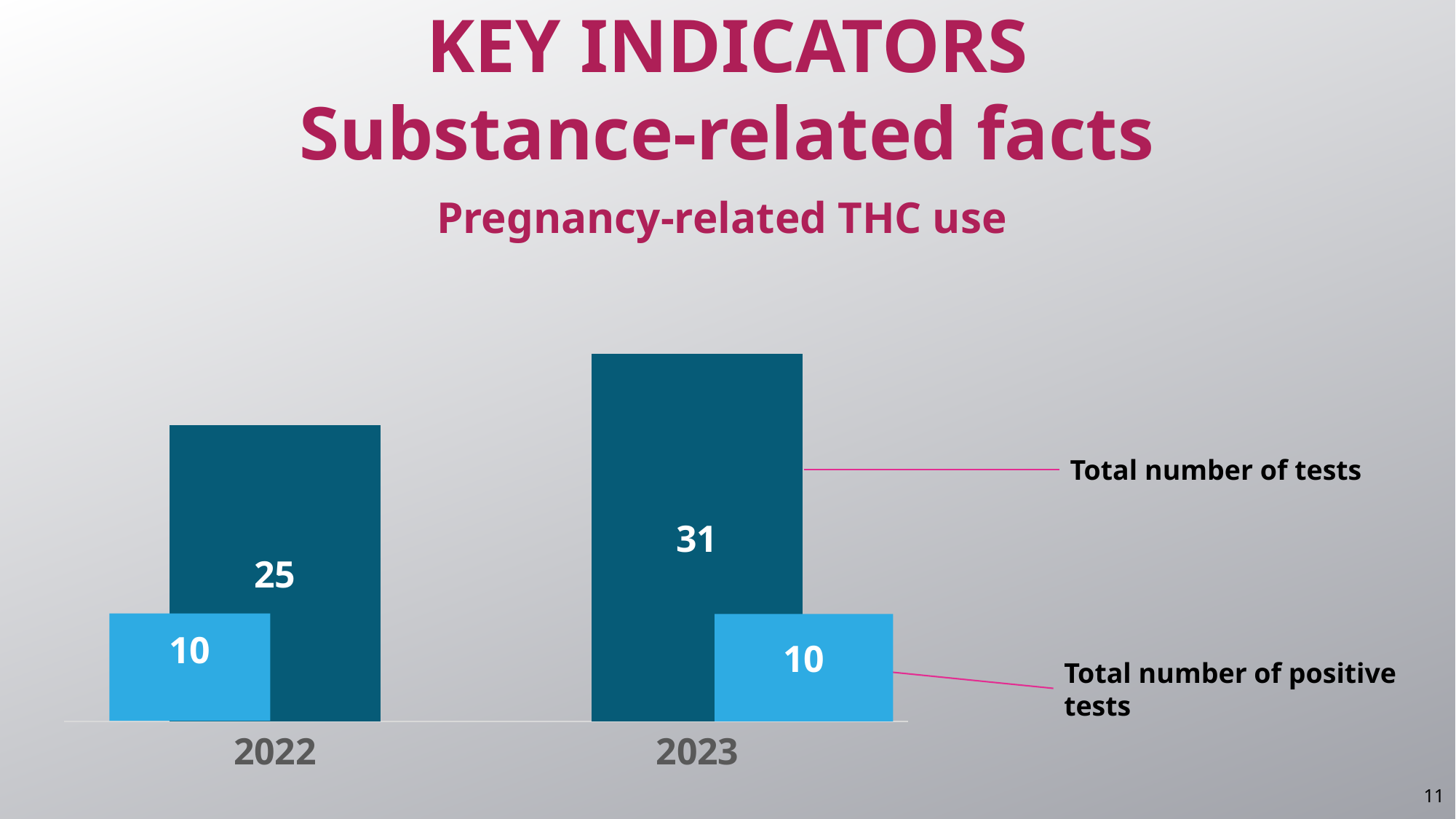
By how much did the total number of tests increase from 2022 to 2023? 6 What was the total number of positive tests in 2022? 10 How many years are shown on the x axis of the chart? 2 Did the total number of positive tests change between 2022 and 2023? No, it stayed at 10 What type of chart is shown on the slide? Bar chart How many data series does the chart show? 2 What is the subtitle describing the chart's subject? Pregnancy-related THC use What is the difference between the total number of tests and the total number of positive tests in 2023? 21 What was the total number of positive tests in 2023? 10 Which year had the higher total number of tests? 2023 What was the total number of tests in 2023? 31 What was the total number of tests in 2022? 25